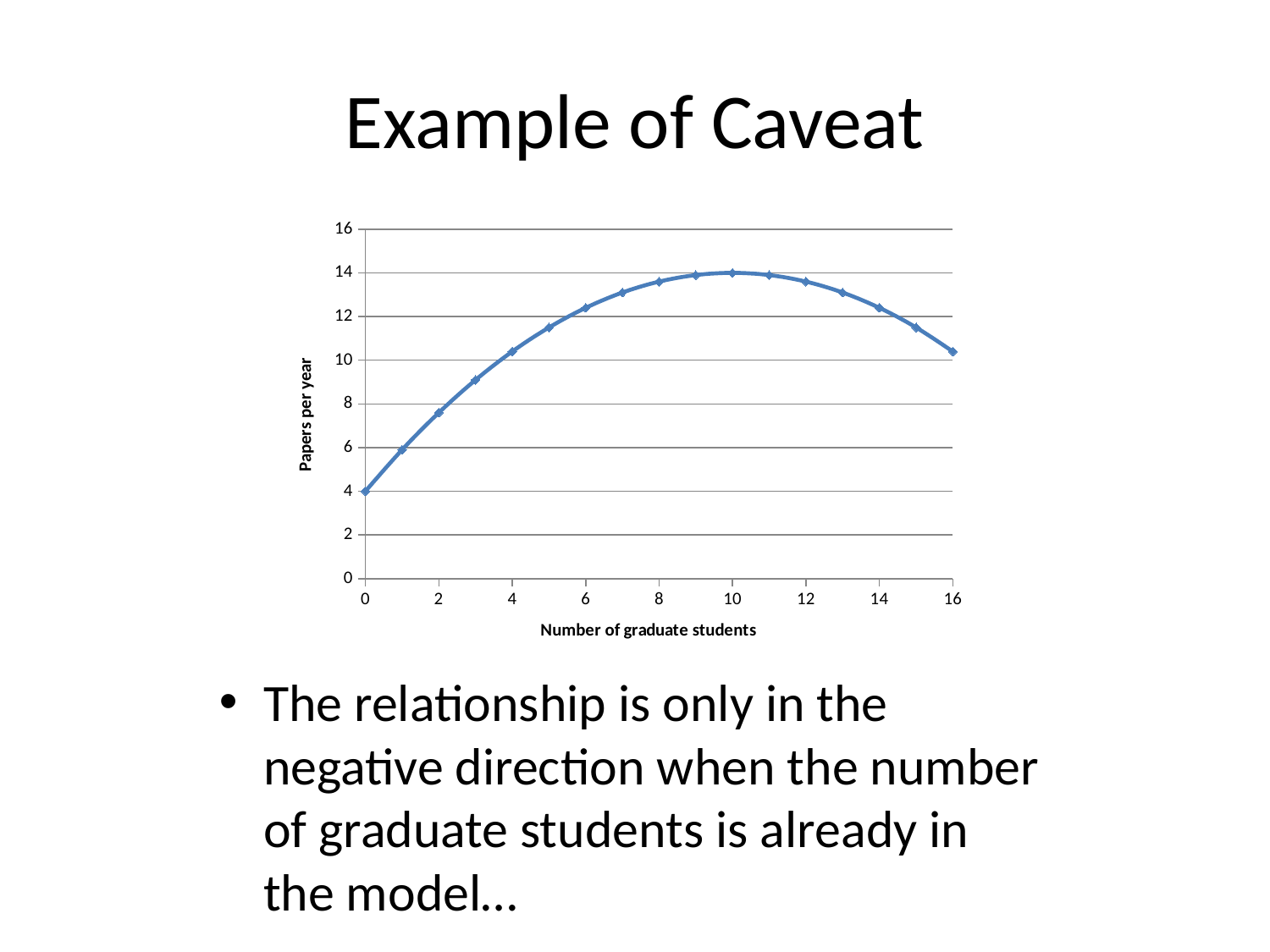
Is the value of papers per year at 16 graduate students greater or less than 12? less What kind of chart is shown on the slide? line chart How many data points are plotted on the line? 17 What is the label of the x axis? Number of graduate students What is the value of papers per year when the number of graduate students is 10? 14 What is the label of the y axis? Papers per year What is the value of papers per year when the number of graduate students is 0? 4 At which number of graduate students is papers per year lowest? 0 Which is larger, papers per year at 2 graduate students or at 14 graduate students? 14 graduate students At which number of graduate students is papers per year highest? 10 Is the value of papers per year at 4 graduate students greater or less than 8? greater How do papers per year change as the number of graduate students increases from 10 to 16? they fall